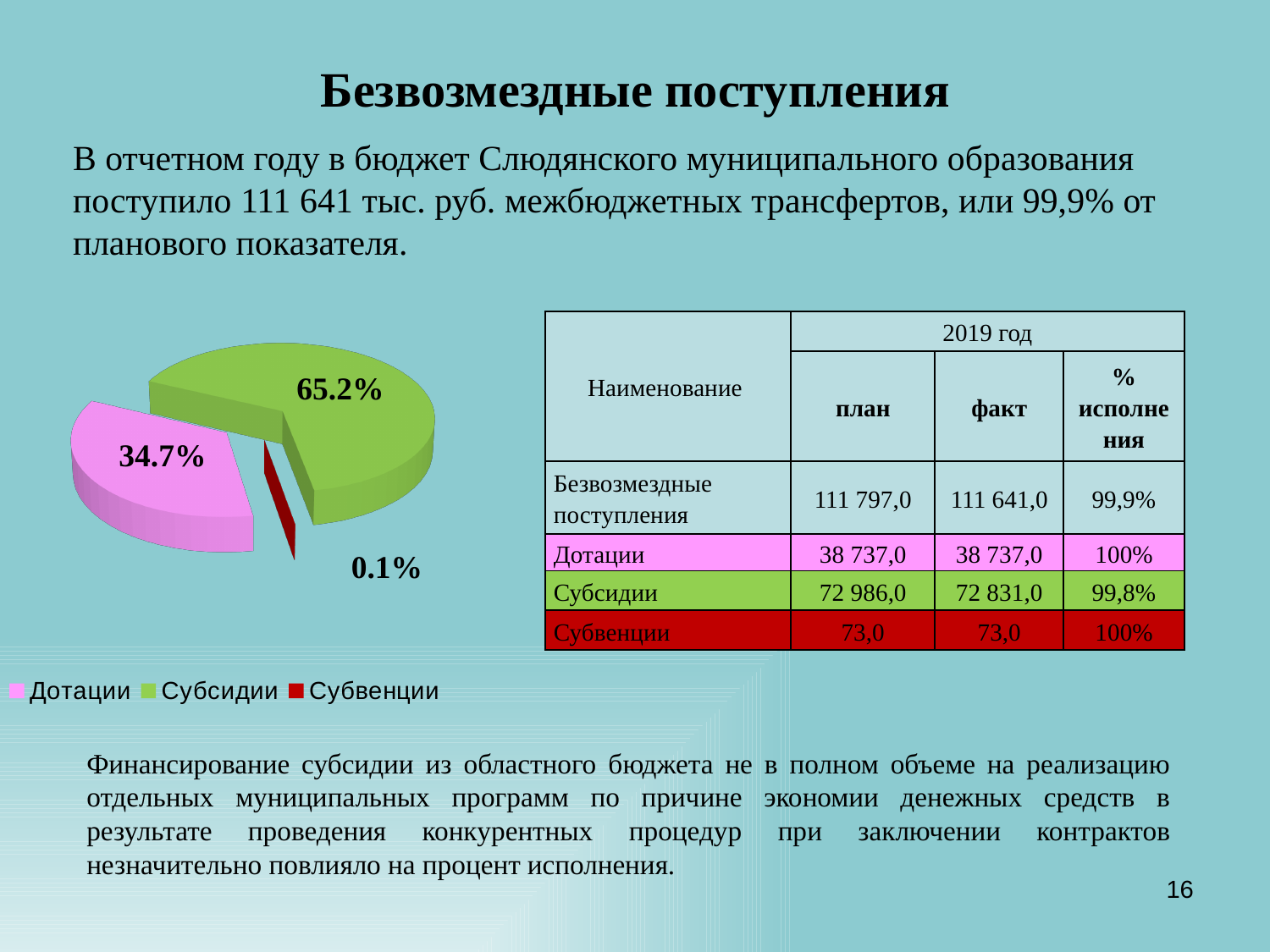
Which category has the largest slice in the pie chart? Субсидии What colour represents Субвенции in the pie chart legend? Red Which category has the smallest slice in the pie chart? Субвенции What share of the pie chart does Субсидии account for? 65.2% How many slices does the pie chart have? 3 What share of the pie chart does Субвенции account for? 0.1% Which slice is larger in the pie chart, Дотации or Субсидии? Субсидии How many entries does the legend of the pie chart list? 3 By how many percentage points does the Субсидии slice exceed the Дотации slice? 30.5% What type of chart is shown on the slide? Pie chart What share of the pie chart does Дотации account for? 34.7% By how many percentage points does the Дотации slice exceed the Субвенции slice? 34.6%